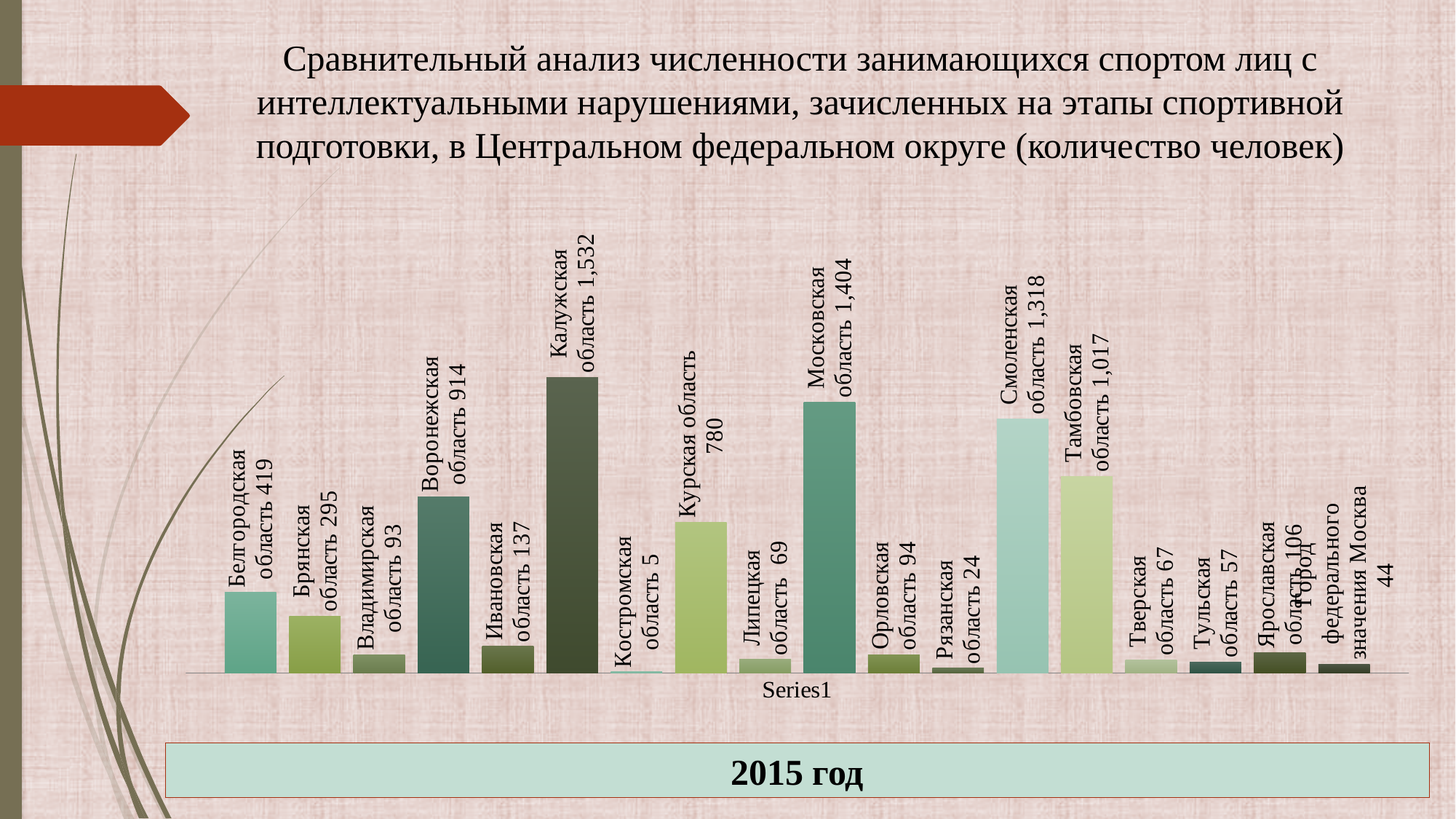
What is the value for Московская область? 1,404 How many regions are shown in the chart? 18 What is the difference between the values for Калужская область and Московская область? 128 Which region has the lowest value? Костромская область What is the value for Калужская область? 1,532 What is the difference between the values for Воронежская область and Курская область? 134 What kind of chart is shown on the slide? bar chart What is the value for Город федерального значения Москва? 44 What is the value for Костромская область? 5 Which region has the highest value? Калужская область Which is larger, the value for Смоленская область or Тамбовская область? Смоленская область What year is indicated in the box below the chart? 2015 год